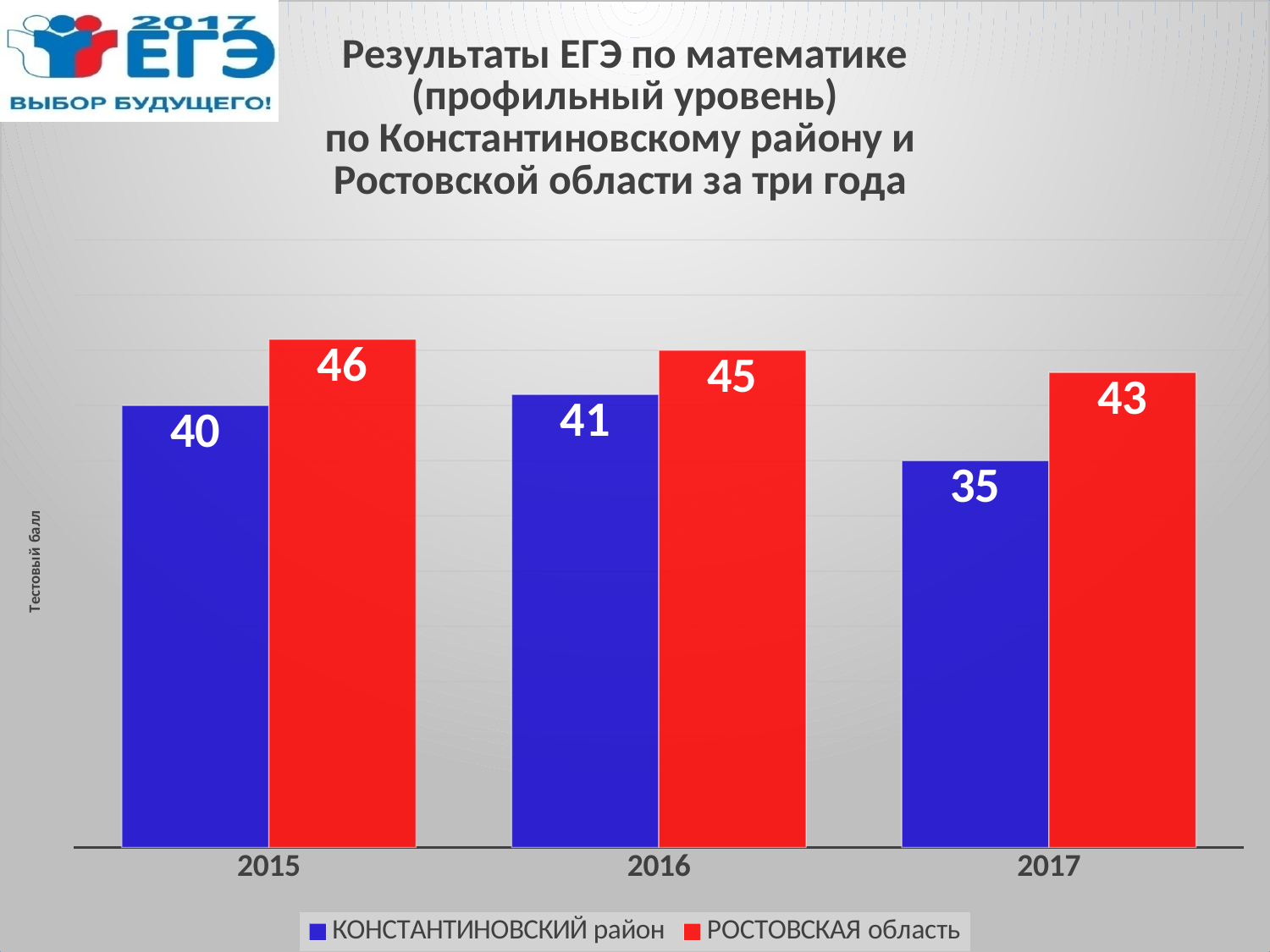
Which is larger in 2016: КОНСТАНТИНОВСКИЙ район or РОСТОВСКАЯ область? РОСТОВСКАЯ область How many years are shown on the x axis? 3 What is the value for КОНСТАНТИНОВСКИЙ район in 2017? 35 How many series does the legend list? 2 What is the value for РОСТОВСКАЯ область in 2017? 43 What kind of chart is shown on the slide? bar chart Does the value for РОСТОВСКАЯ область rise or fall from 2015 to 2017? fall In which year is the value for РОСТОВСКАЯ область highest? 2015 What is the value for КОНСТАНТИНОВСКИЙ район in 2015? 40 What is the difference between РОСТОВСКАЯ область and КОНСТАНТИНОВСКИЙ район in 2017? 8 What is the difference between РОСТОВСКАЯ область and КОНСТАНТИНОВСКИЙ район in 2016? 4 In which year is the value for КОНСТАНТИНОВСКИЙ район lowest? 2017